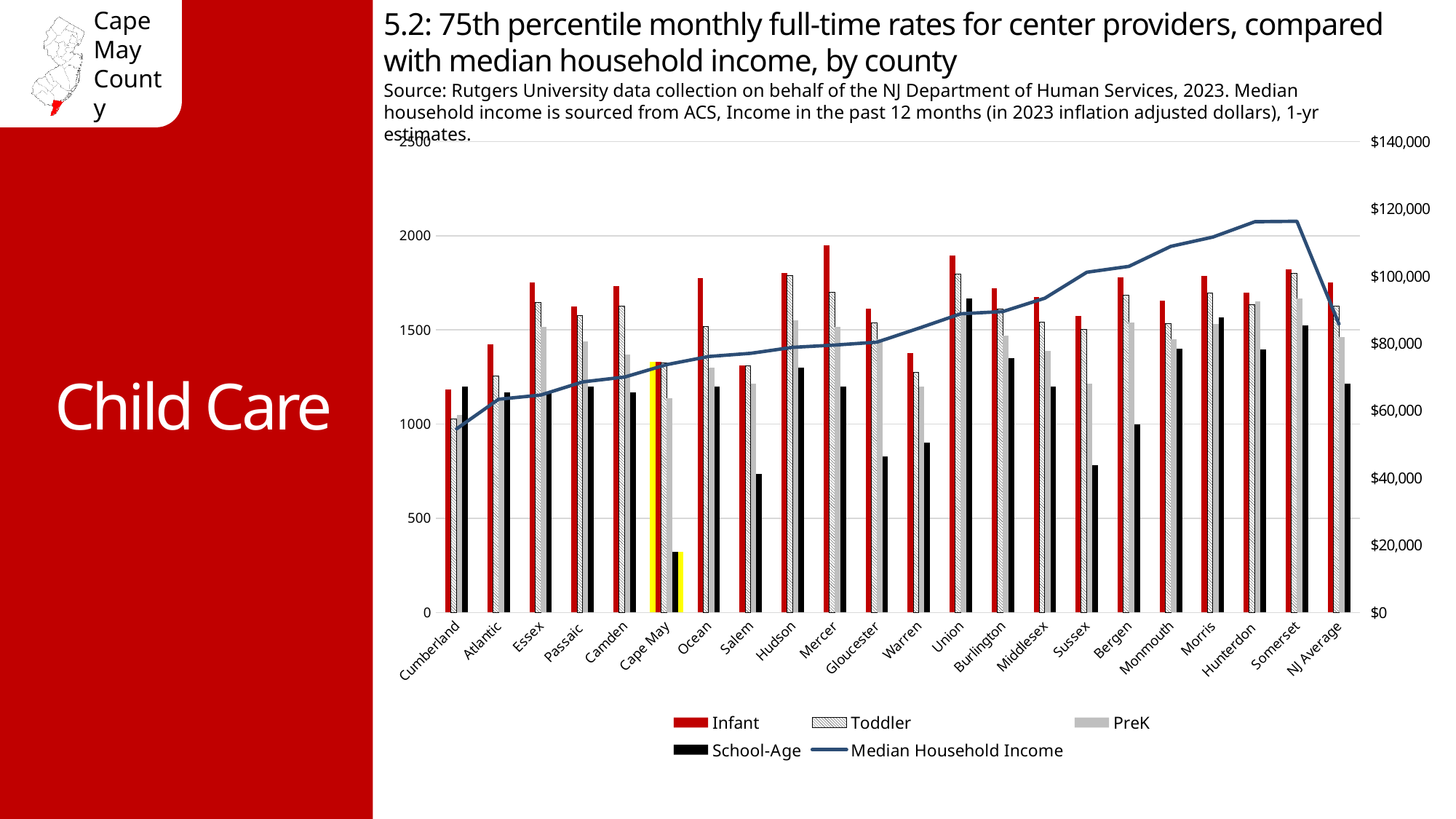
Which series is plotted as a line rather than bars? Median Household Income How many series does the legend list? 5 Is the School-Age value for Salem greater or less than 1000? less Which county has the lowest School-Age rate? Cape May Is the Infant value for Mercer greater or less than 1500? greater How many counties (including NJ Average) are shown on the x axis? 22 Which county has the highest Infant rate? Mercer Is the School-Age value for Cape May greater or less than 500? less Which county has the lowest Infant rate? Cumberland Does the Median Household Income line generally rise or fall from Cumberland to Somerset? rise What kind of chart is shown on the slide? A bar chart combined with a line chart Which is larger, the Infant rate for Mercer or the Infant rate for Cumberland? Mercer